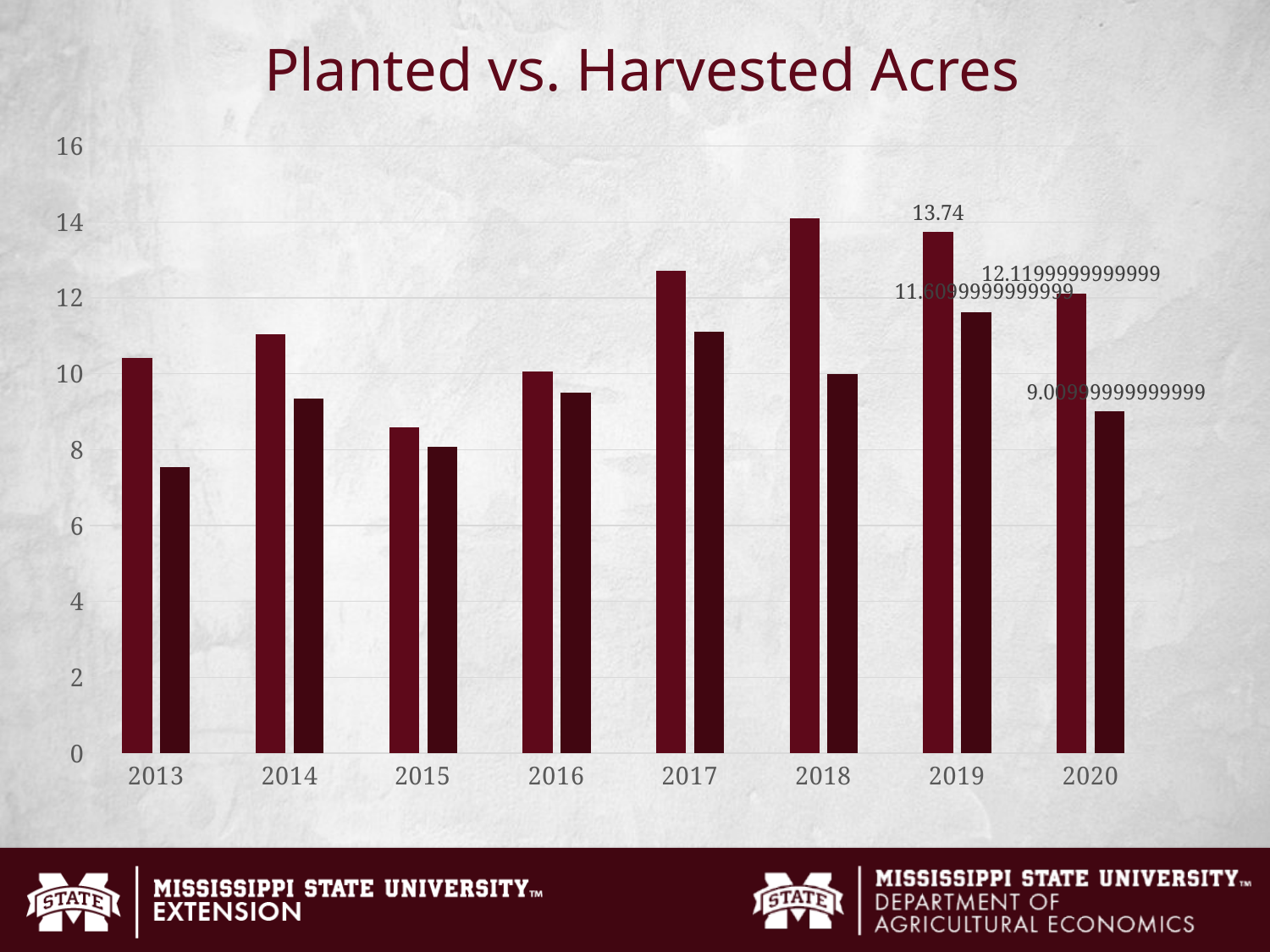
Do the left bars rise or fall from 2015 to 2018? rise What is the value labelled on the right (shorter) bar for 2020? 9.00999999999999 Is the value of the left bar for 2015 greater or less than 10? less How many bars are plotted for each year in the chart? 2 What is the value labelled on the left (taller) bar for 2020? 12.1199999999999 What is the value labelled on the left (taller) bar for 2019? 13.74 Which year has the tallest left bar in the chart? 2018 What is the title of the chart? Planted vs. Harvested Acres Which year has the shortest right bar in the chart? 2013 Is the value of the left bar for 2013 greater or less than 10? greater What kind of chart is shown on the slide? bar chart How many years are shown on the x axis of the chart? 8